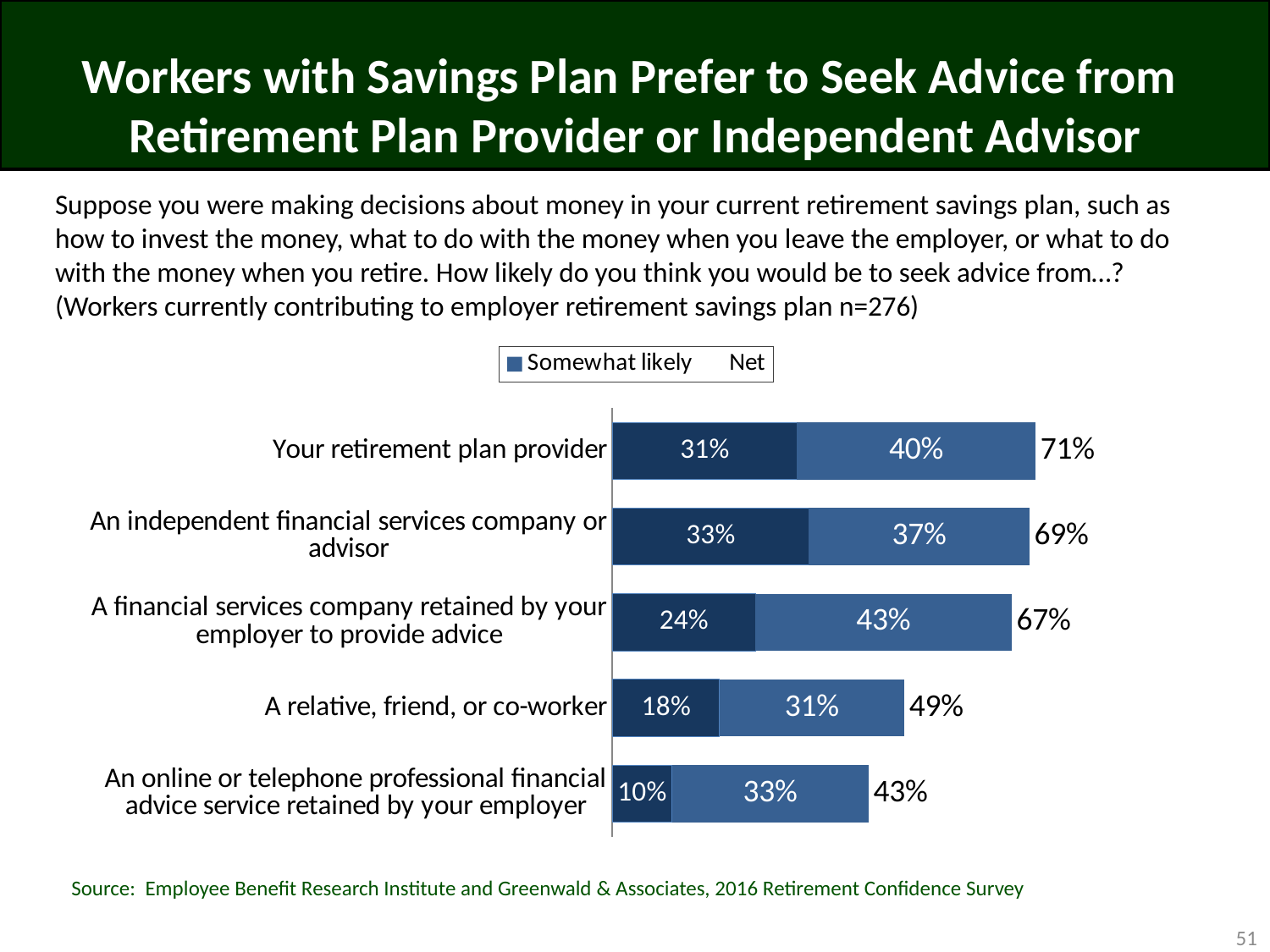
What is the value of the lighter blue segment for "A financial services company retained by your employer to provide advice"? 43% What kind of chart is shown on the slide? Stacked bar chart What is the total of the stacked bar for "A relative, friend, or co-worker"? 49% Which category has the highest net value? Your retirement plan provider What is the value of the dark blue segment for "An independent financial services company or advisor"? 33% Which category has the lowest net value? An online or telephone professional financial advice service retained by your employer Which has a larger dark blue segment: "A relative, friend, or co-worker" or "An online or telephone professional financial advice service retained by your employer"? A relative, friend, or co-worker How many categories are shown in the chart? 5 What is the difference between the net value for "Your retirement plan provider" and the net value for "A relative, friend, or co-worker"? 22 percentage points Which category has the largest dark blue segment? An independent financial services company or advisor In the bar for "A financial services company retained by your employer to provide advice", what is the difference between the lighter blue segment and the dark blue segment? 19 percentage points What is the net value shown for "Your retirement plan provider"? 71%